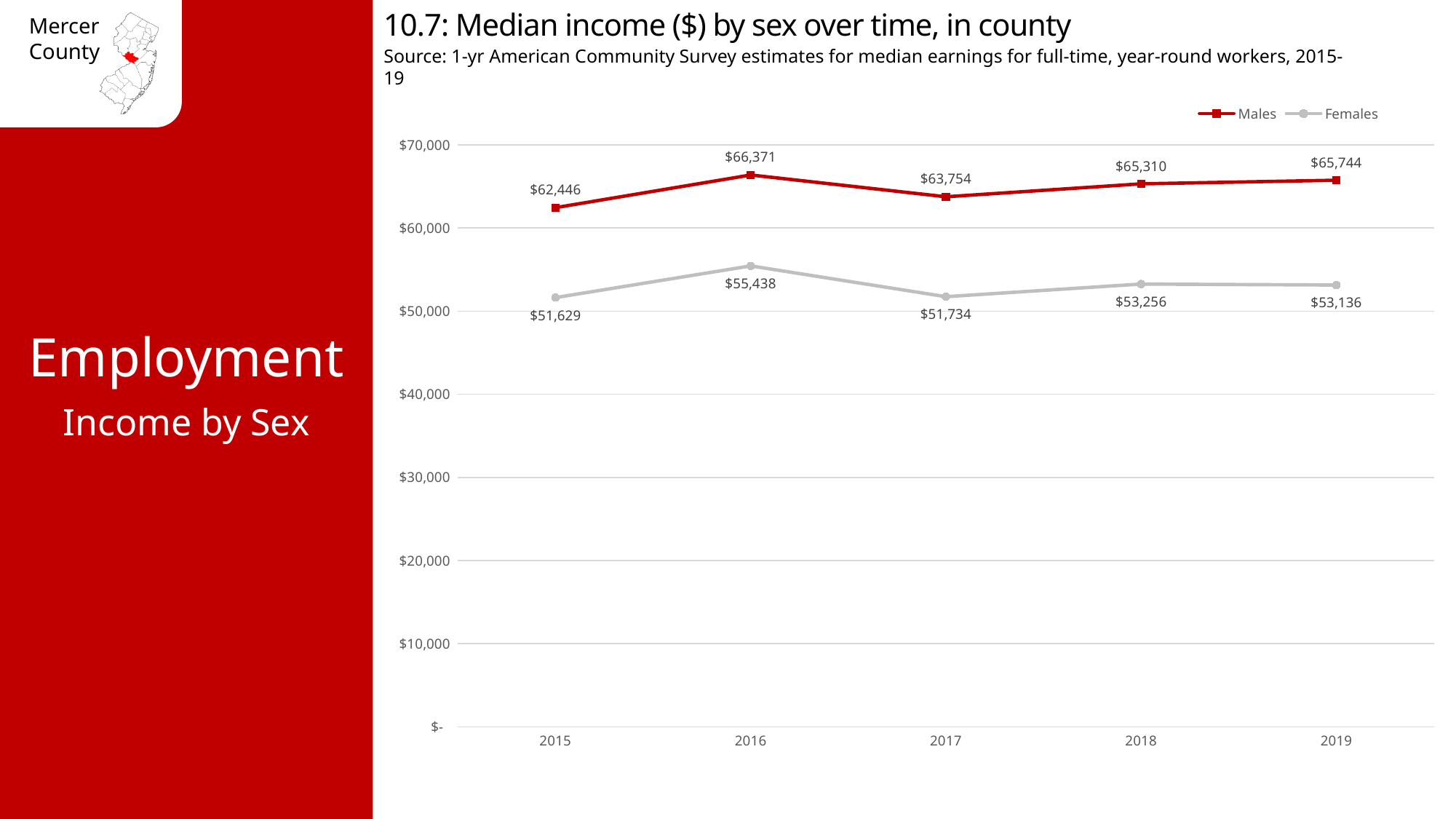
What kind of chart is shown on the slide? line chart Is the median income for males in 2015 greater or less than $60,000? greater In which year was the median income for females lowest? 2015 How many years are shown on the x axis? 5 What was the median income for females in 2015? $51,629 What was the median income for males in 2016? $66,371 How many series does the legend list? 2 What is the difference between male median income in 2016 and 2017? $2,617 What was the median income for females in 2019? $53,136 Which was larger, the female median income in 2018 or in 2017? 2018 What is the difference between male and female median income in 2019? $12,608 In which year was the median income for males highest? 2016